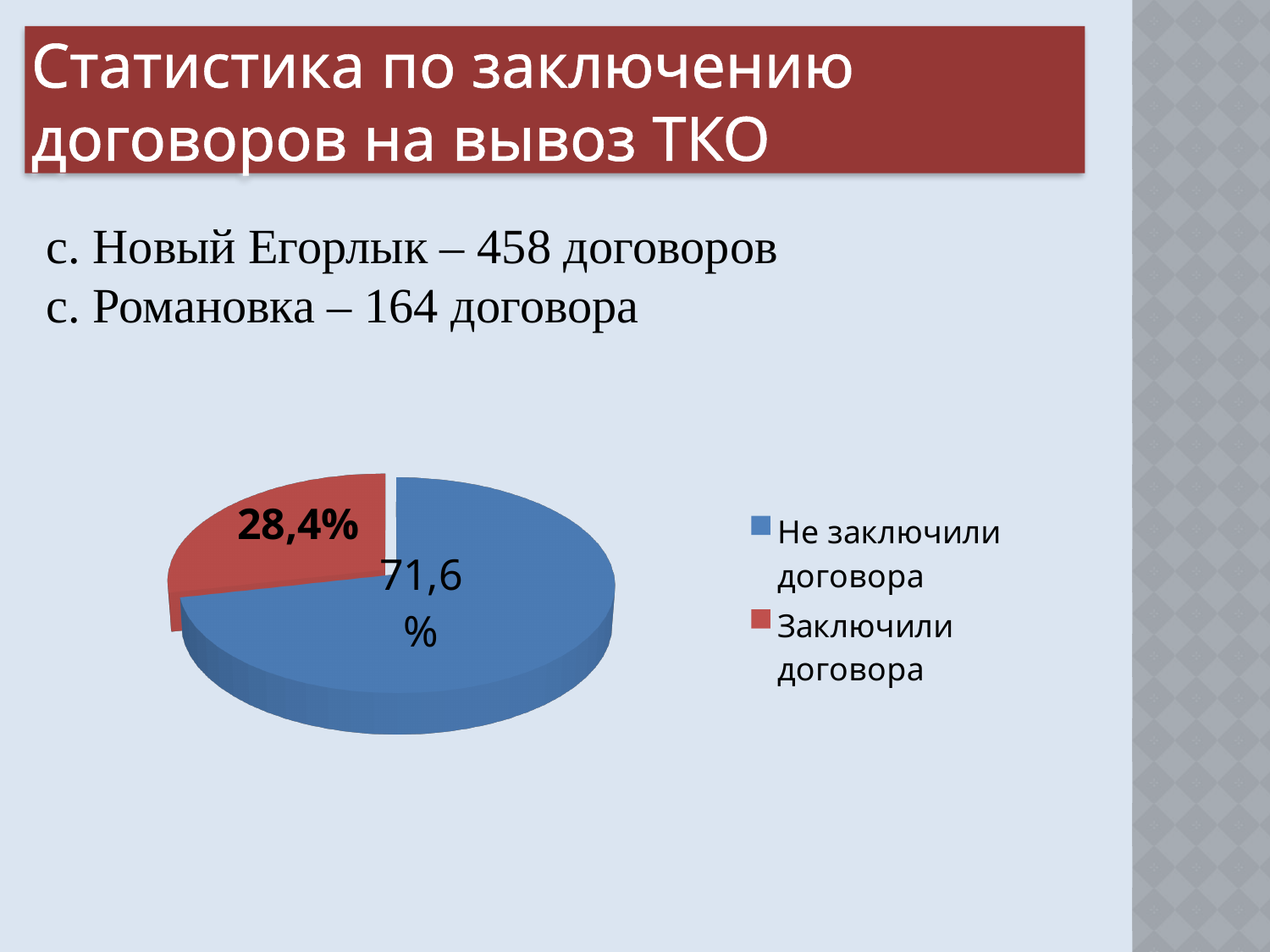
Which slice of the pie is the largest? Не заключили договора What share of the pie does the slice "Заключили договора" represent? 28,4% What is the difference in percentage points between the "Не заключили договора" slice and the "Заключили договора" slice? 43,2 Which is larger: the share for "Не заключили договора" or the share for "Заключили договора"? Не заключили договора What kind of chart is shown on the slide? Pie chart What is the total of the two slice percentages shown on the pie chart? 100% How many entries does the chart legend list? 2 What share of the pie does the slice "Не заключили договора" represent? 71,6% What colour is the slice for "Не заключили договора"? Blue Which slice of the pie is the smallest? Заключили договора How many slices does the pie chart have? 2 What colour is the slice for "Заключили договора"? Red